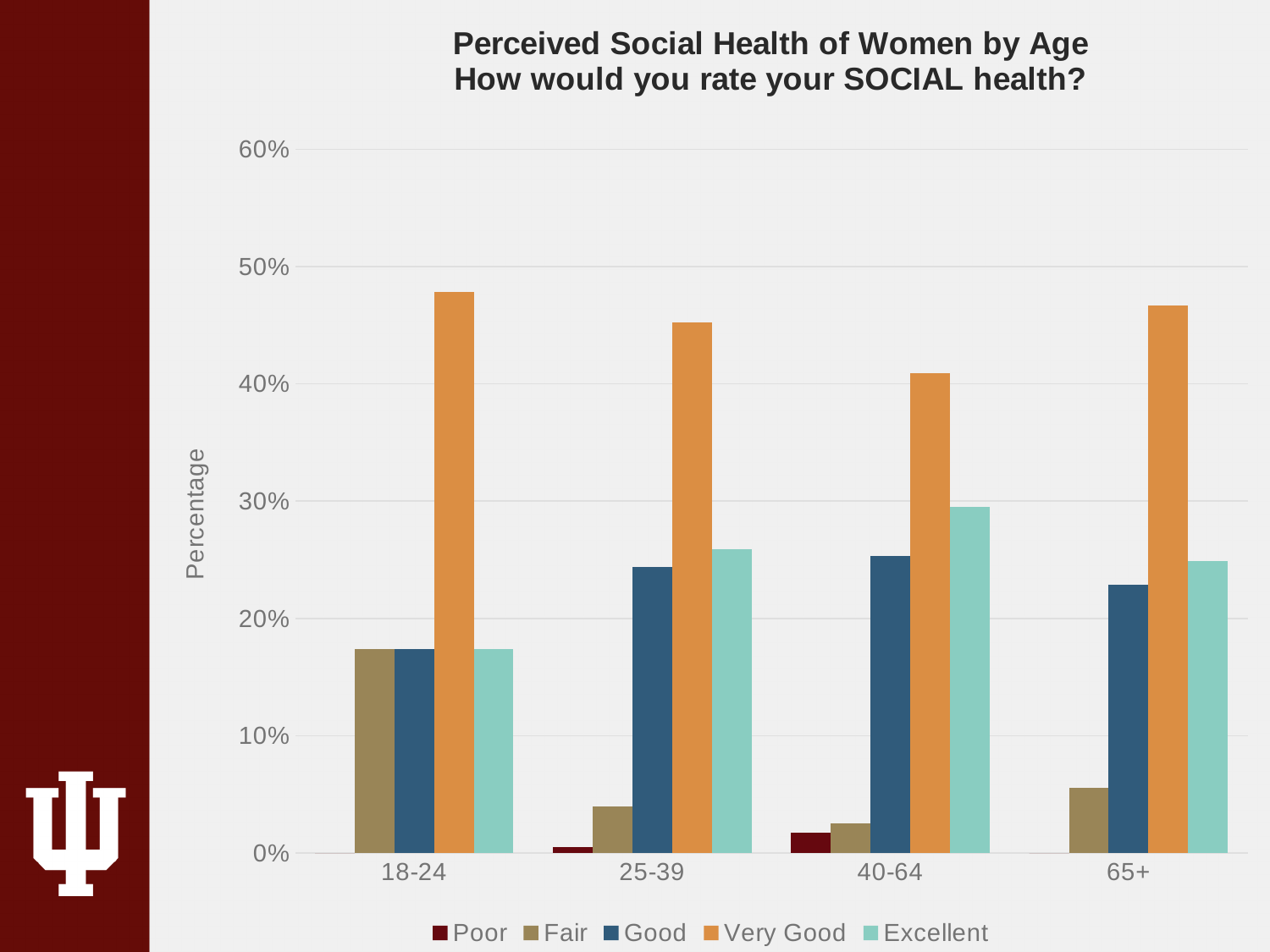
Which is larger: Fair for 18-24 or Fair for 25-39? Fair for 18-24 How many series does the legend list? 5 What is the label on the y axis? Percentage In the 40-64 group, which is larger: Good or Excellent? Excellent How many age groups are shown on the x axis? 4 Which rating has the tallest bar in every age group? Very Good Is the value for Fair in the 18-24 group greater or less than 20%? less Is the value for Very Good in the 18-24 group greater or less than 40%? greater What type of chart is shown on the slide? bar chart Which age group has the highest value for Excellent? 40-64 Which age group has the lowest value for Very Good? 40-64 Is the value for Good in the 25-39 group greater or less than 20%? greater